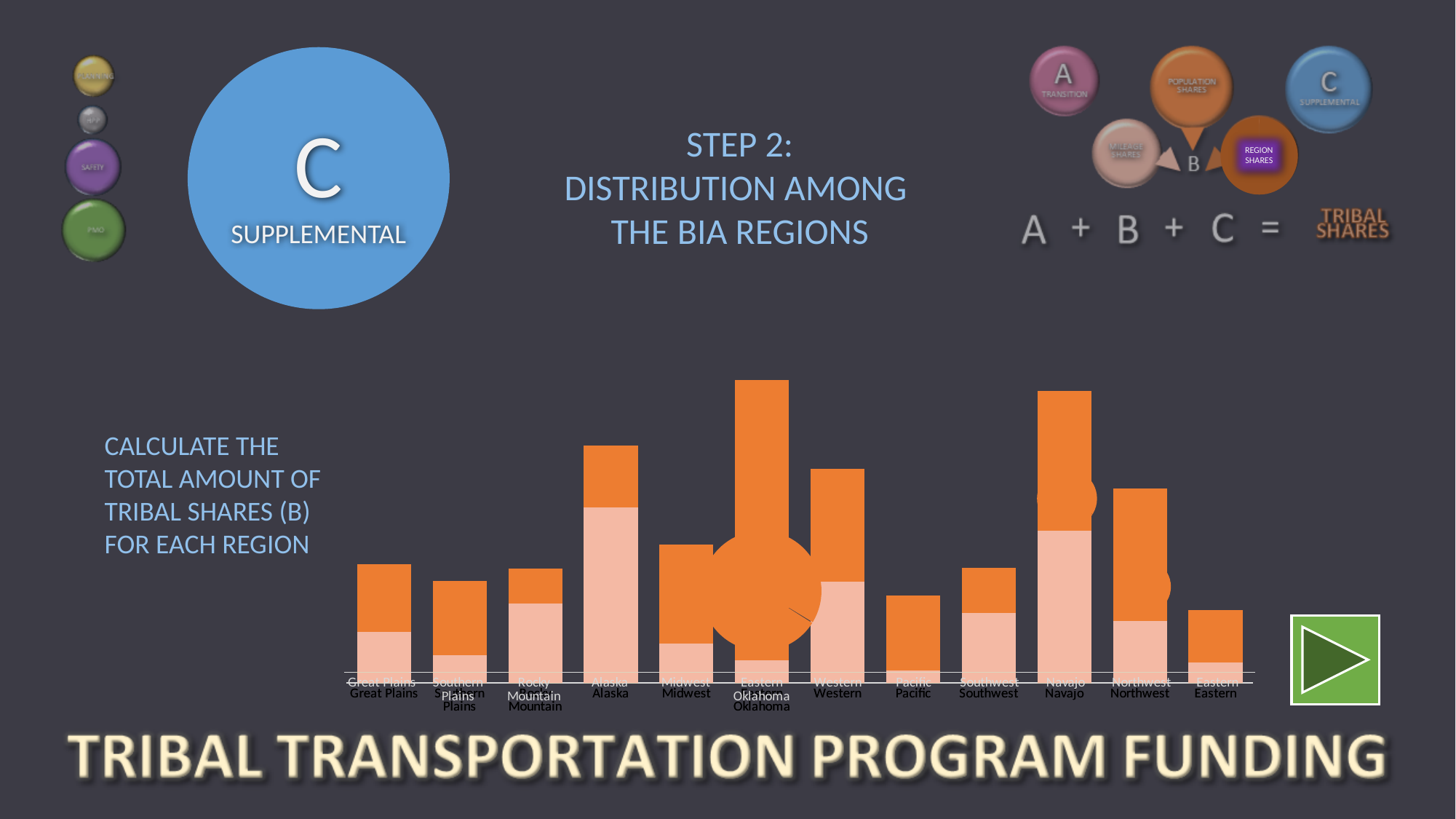
How many regions (categories) are shown along the x axis of the chart? 12 Which bar is taller in the chart, Rocky Mountain or Alaska? Alaska How many stacked segments does each bar in the chart have? 2 Does the chart display a legend? No Which bar is taller in the chart, Northwest or Eastern? Northwest Which bar is taller in the chart, Western or Midwest? Western What kind of chart is shown on the slide? Stacked bar chart Which region's bar is the tallest in the chart? Eastern Oklahoma